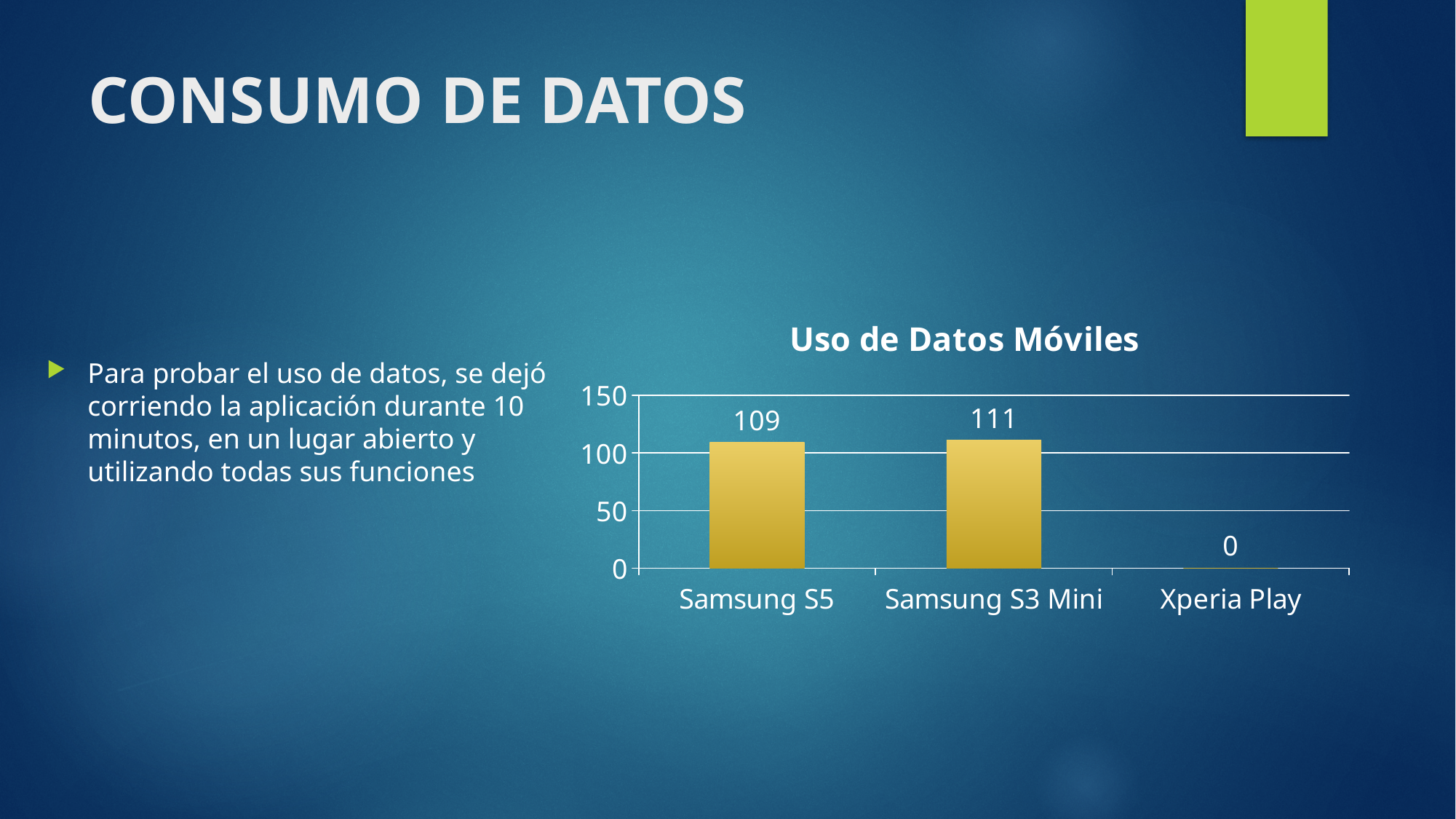
What is the difference between the values for Samsung S3 Mini and Samsung S5? 2 What is the value for Samsung S5? 109 What kind of chart is shown on the slide? bar chart Which is larger, the value for Samsung S5 or the value for Xperia Play? Samsung S5 Which category has the highest value? Samsung S3 Mini Which category has the lowest value? Xperia Play What is the value for Samsung S3 Mini? 111 Is the value for Samsung S5 greater or less than 100? greater Is the value for Samsung S3 Mini greater or less than 150? less How many categories are shown on the x axis? 3 What is the value for Xperia Play? 0 What is the title of the chart? Uso de Datos Móviles